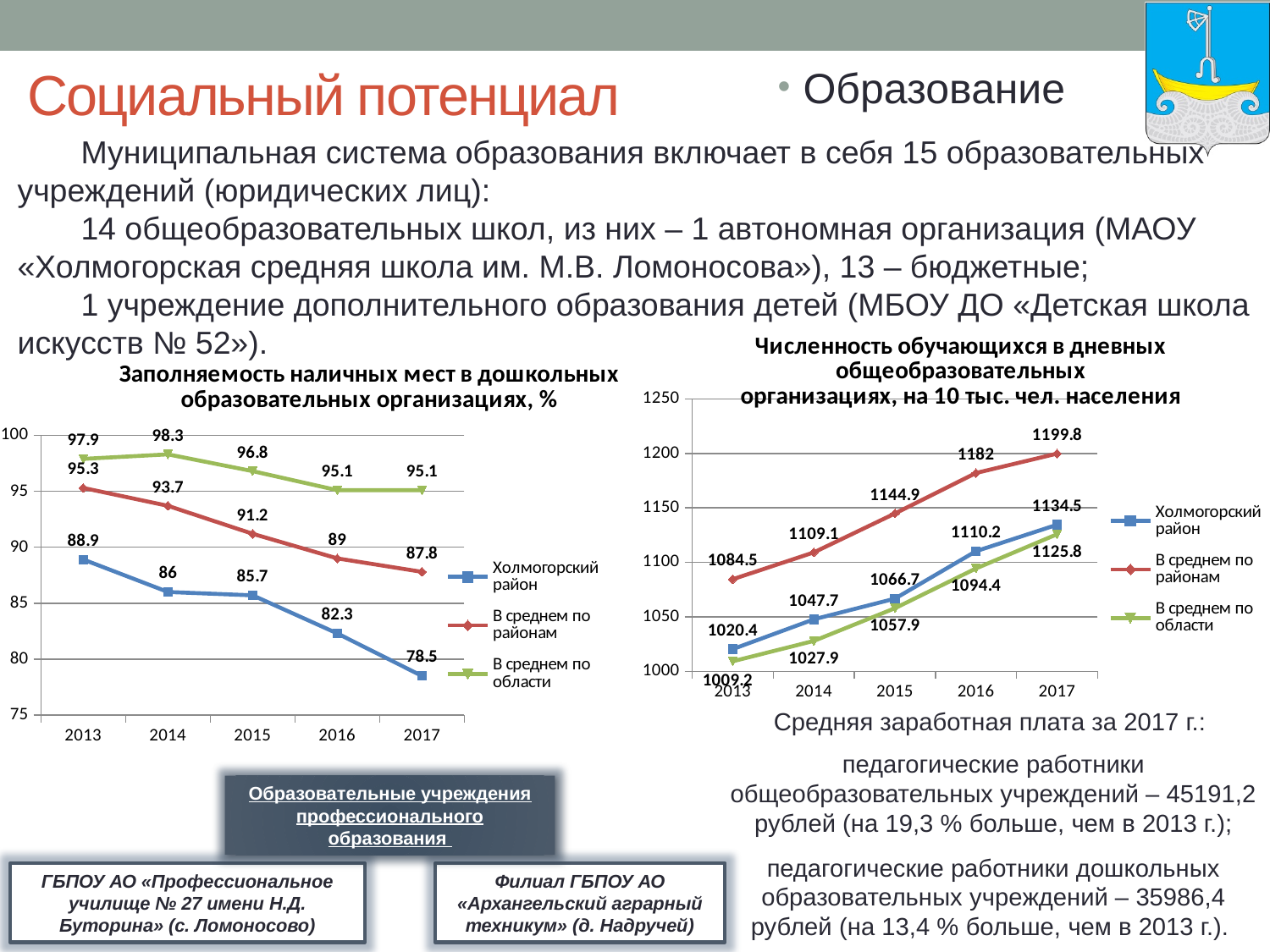
On the chart 'Заполняемость наличных мест в дошкольных образовательных организациях, %', what is the value for В среднем по области in 2014? 98.3 On the chart 'Численность обучающихся в дневных общеобразовательных организациях, на 10 тыс. чел. населения', which series has the lowest value in 2013? В среднем по области On the chart 'Численность обучающихся в дневных общеобразовательных организациях, на 10 тыс. чел. населения', what is the difference between the 2017 and 2013 values for Холмогорский район? 114.1 On the chart 'Заполняемость наличных мест в дошкольных образовательных организациях, %', how many series does the legend list? 3 On the chart 'Численность обучающихся в дневных общеобразовательных организациях, на 10 тыс. чел. населения', how many years are shown on the x axis? 5 On the chart 'Заполняемость наличных мест в дошкольных образовательных организациях, %', what is the value for Холмогорский район in 2017? 78.5 On the chart 'Заполняемость наличных мест в дошкольных образовательных организациях, %', does the value for Холмогорский район rise or fall from 2013 to 2017? fall On the chart 'Численность обучающихся в дневных общеобразовательных организациях, на 10 тыс. чел. населения', what is the value for В среднем по районам in 2016? 1182 On the chart 'Заполняемость наличных мест в дошкольных образовательных организациях, %', in which year is the value for Холмогорский район highest? 2013 On the chart 'Численность обучающихся в дневных общеобразовательных организациях, на 10 тыс. чел. населения', what is the value for Холмогорский район in 2015? 1066.7 On the chart 'Заполняемость наличных мест в дошкольных образовательных организациях, %', what is the difference between В среднем по районам and Холмогорский район in 2013? 6.4 What type of chart is 'Численность обучающихся в дневных общеобразовательных организациях, на 10 тыс. чел. населения'? line chart